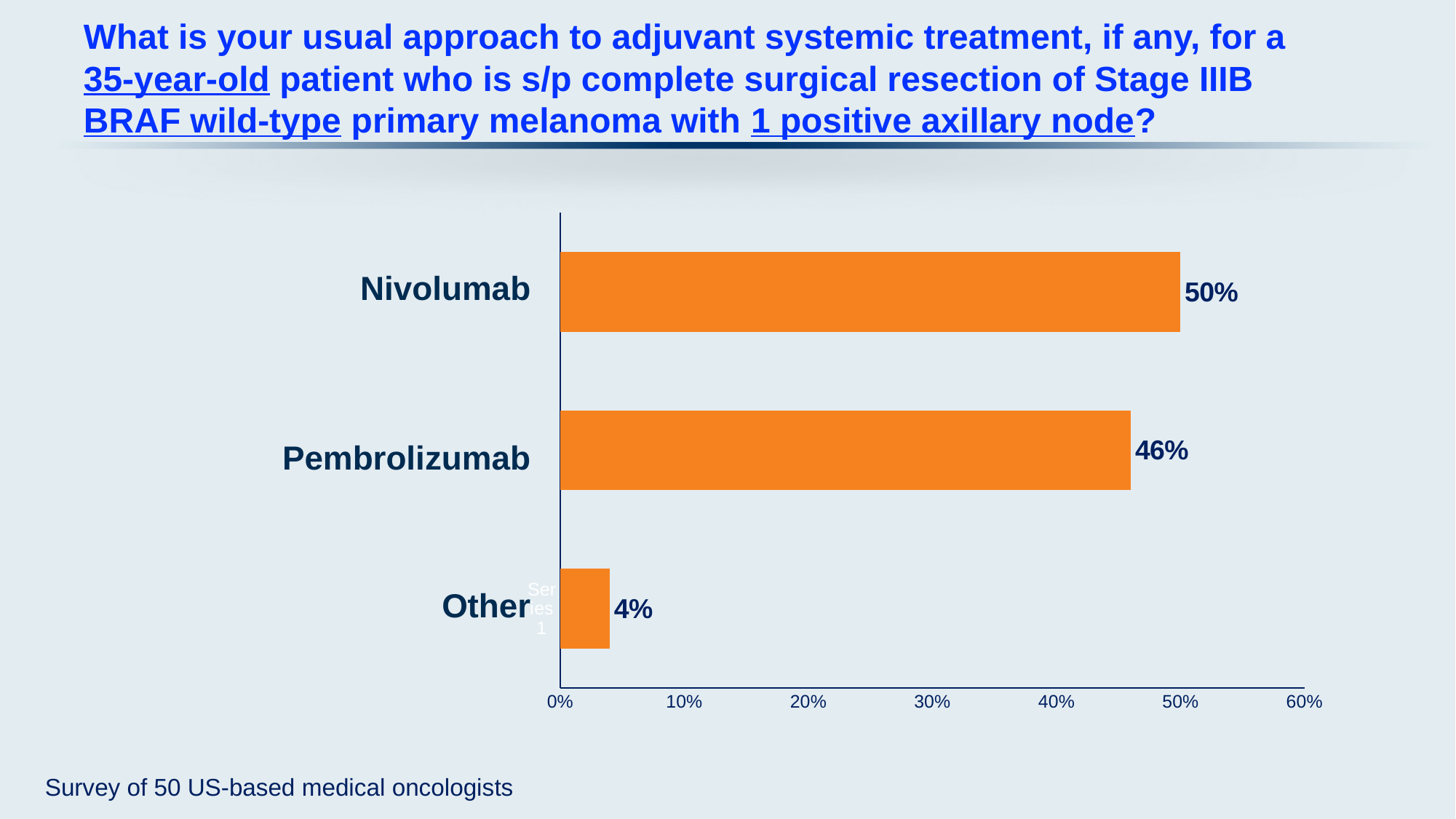
Which option has the highest percentage? Nivolumab What percentage of respondents chose Pembrolizumab? 46% What is the maximum value shown on the x axis? 60% Which has a larger percentage, Nivolumab or Pembrolizumab? Nivolumab What percentage of respondents chose Other? 4% What is the difference in percentage points between Nivolumab and Pembrolizumab? 4 What kind of chart is shown on the slide? Bar chart Which option has the lowest percentage? Other What is the difference in percentage points between Pembrolizumab and Other? 42 Is the value for Pembrolizumab greater or less than 40%? greater What percentage of respondents chose Nivolumab? 50% How many categories are shown in the chart? 3